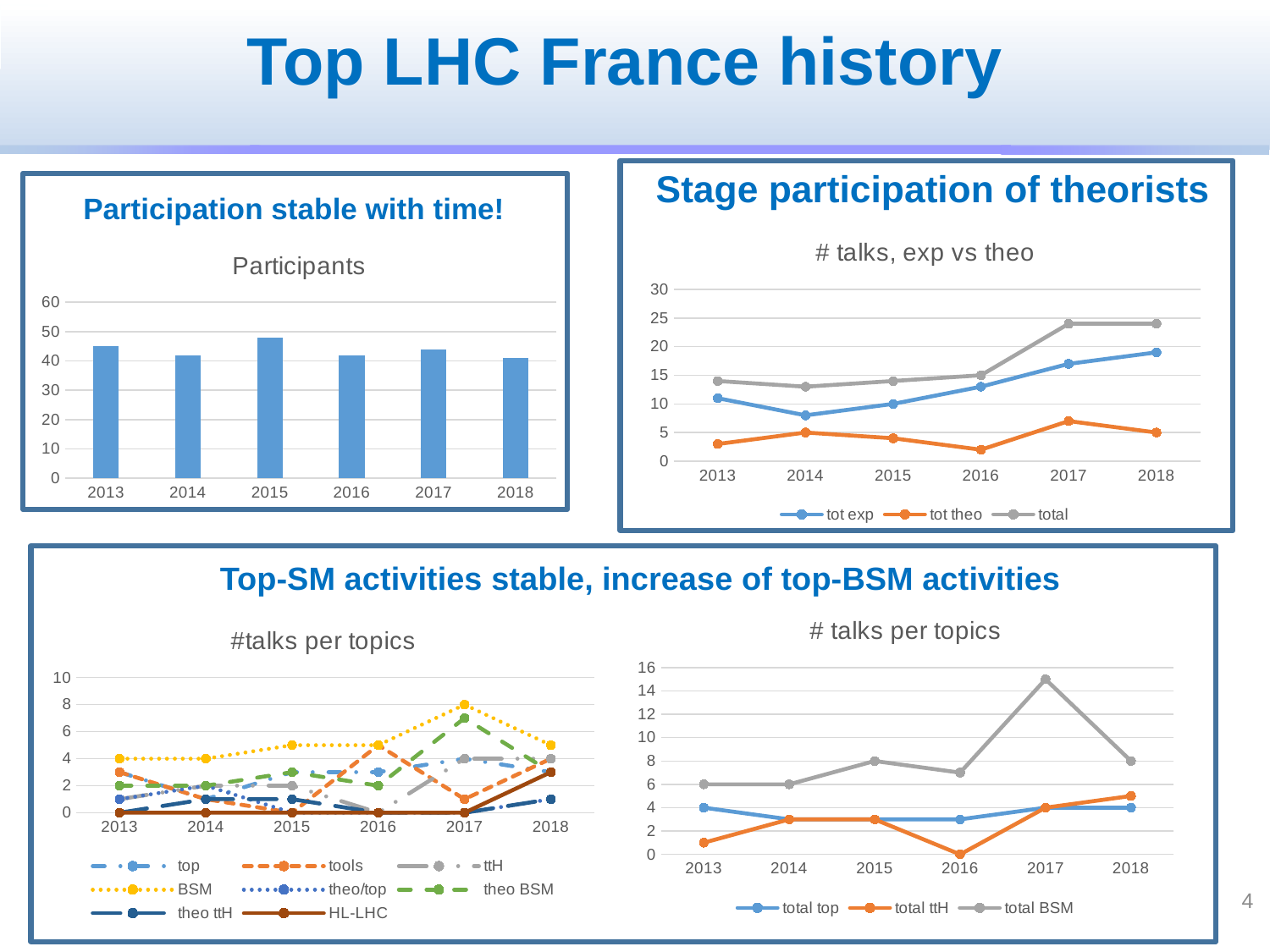
How many years are shown on the x axis of the "Participants" chart? 6 How many series does the legend of the bottom-right "# talks per topics" chart list? 3 In the "Participants" chart, which year has the highest number of participants? 2015 What kind of chart is the "Participants" chart on the left? bar chart In the bottom-right "# talks per topics" chart, in which year does "total BSM" reach its highest value? 2017 In the bottom-right "# talks per topics" chart, what is the value of "total ttH" in 2016? 0 In the "# talks, exp vs theo" chart, is the value of "total" in 2017 greater or less than 20? greater In the "# talks, exp vs theo" chart, does the "tot exp" series rise or fall from 2014 to 2018? rise In the "Participants" chart, is the value for 2013 greater or less than 50? less In the "# talks, exp vs theo" chart, what is the value of "tot exp" in 2015? 10 How many series does the legend of the bottom-left "#talks per topics" chart list? 8 How many series does the legend of the "# talks, exp vs theo" chart list? 3